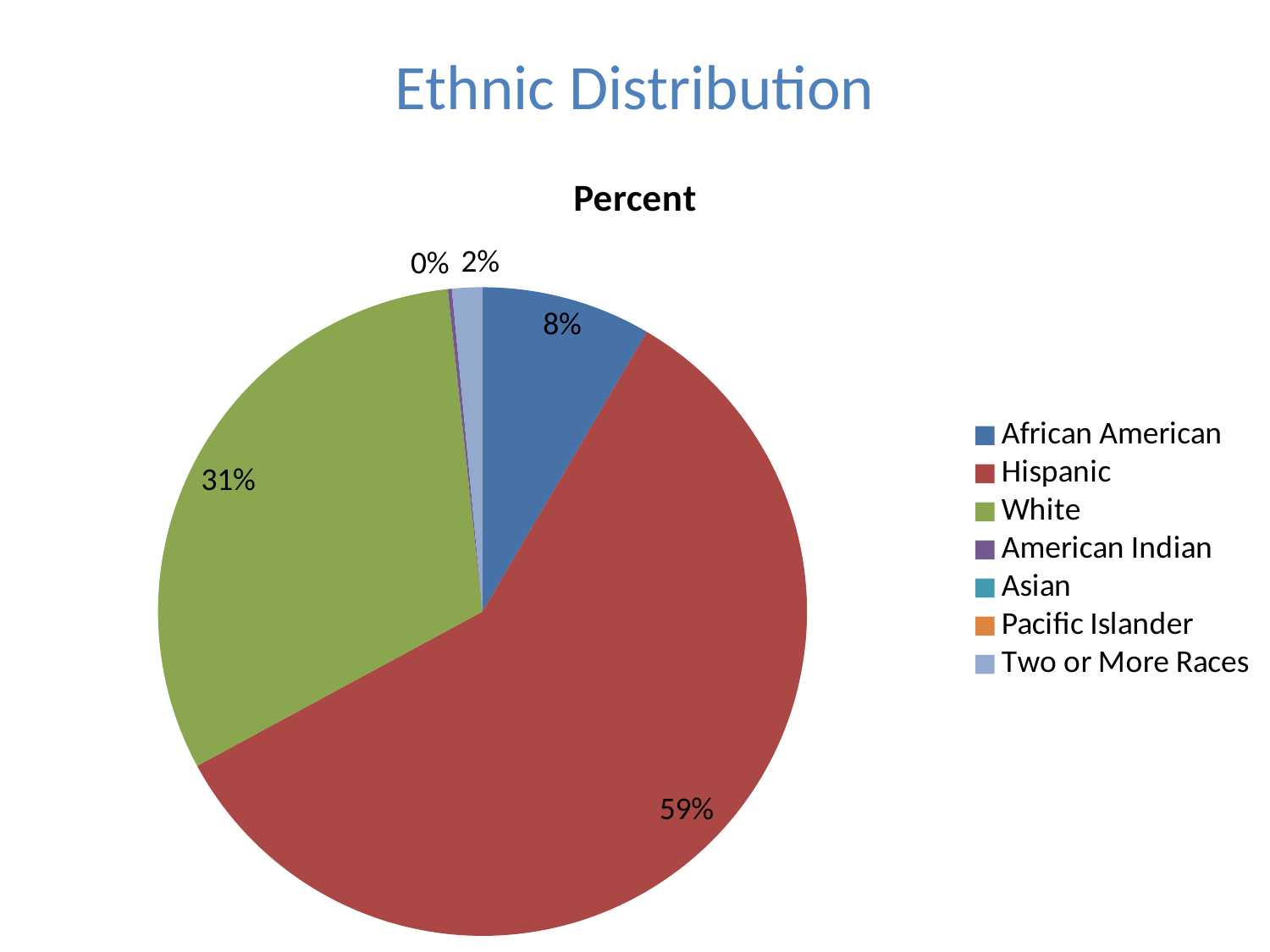
Which category has the largest share of the pie? Hispanic What percentage of the pie is African American? 8% What is the title of the pie chart? Percent What kind of chart is shown on the slide? pie chart What colour is the Hispanic slice? red What percentage of the pie is Hispanic? 59% How many percentage points larger is the Hispanic share than the White share? 28% What percentage of the pie is Two or More Races? 2% How many categories does the legend list? 7 What percentage of the pie is White? 31% Which is larger, the White share or the African American share? White What is the combined share of Hispanic and White? 90%